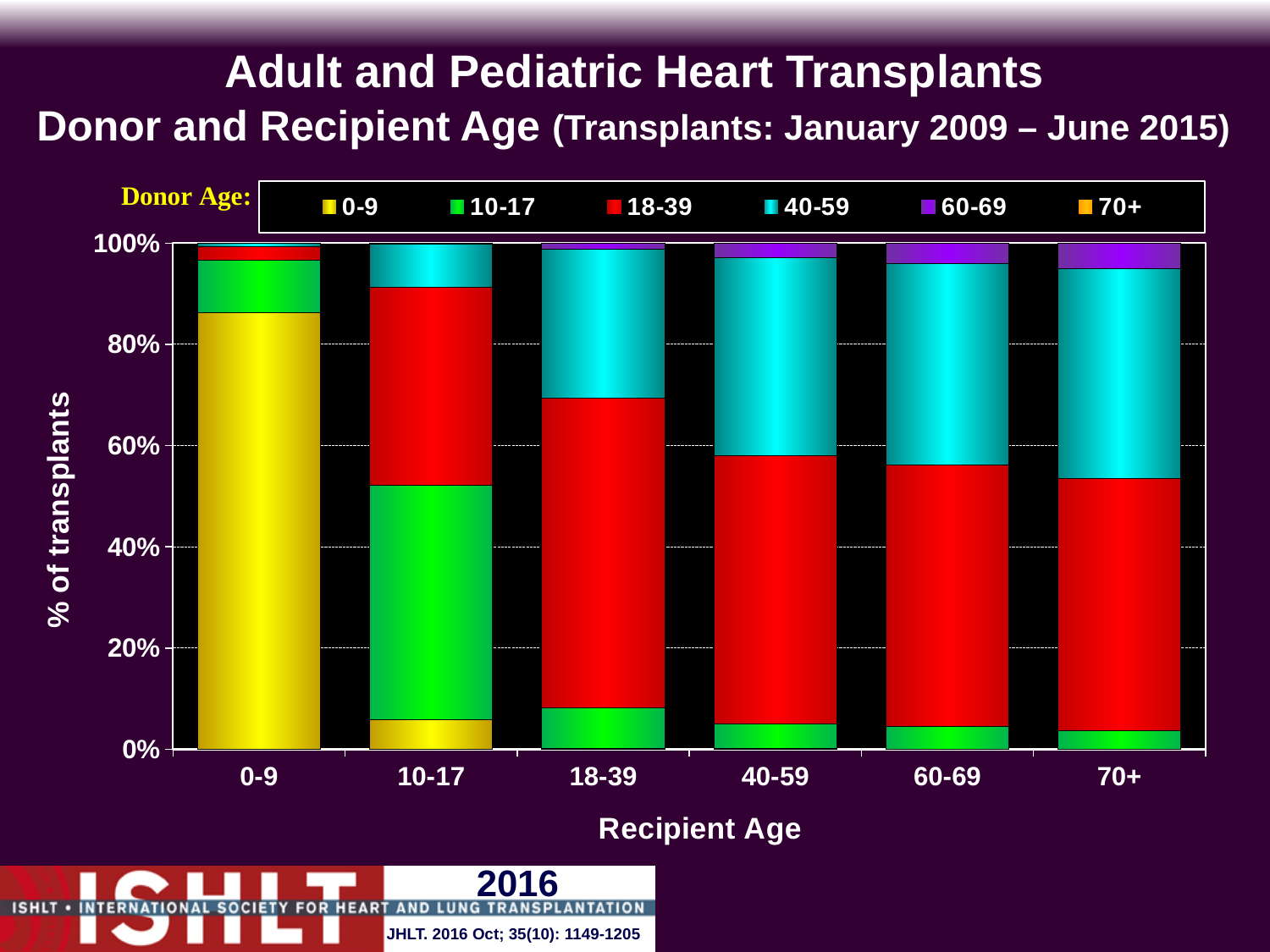
What kind of chart is shown on the slide? Stacked bar chart Which is larger: the share of donors aged 40-59 for recipients aged 70+ or for recipients aged 18-39? Recipients aged 70+ Is the share of donors aged 0-9 for recipients aged 0-9 greater or less than 80%? greater From recipient age 18-39 to 70+, does the share of donors aged 40-59 rise or fall? Rise Which recipient age group has the largest share of donors aged 0-9? 0-9 How many recipient age groups are shown on the x axis? 6 How many donor age groups does the legend list? 6 Which recipient age group has the largest share of donors aged 10-17? 10-17 Is the share of donors aged 10-17 for recipients aged 10-17 greater or less than 40%? greater What is the title of the y axis? % of transplants From recipient age 18-39 to 70+, does the share of donors aged 18-39 rise or fall? Fall Is the share of donors aged 18-39 for recipients aged 18-39 greater or less than 50%? greater